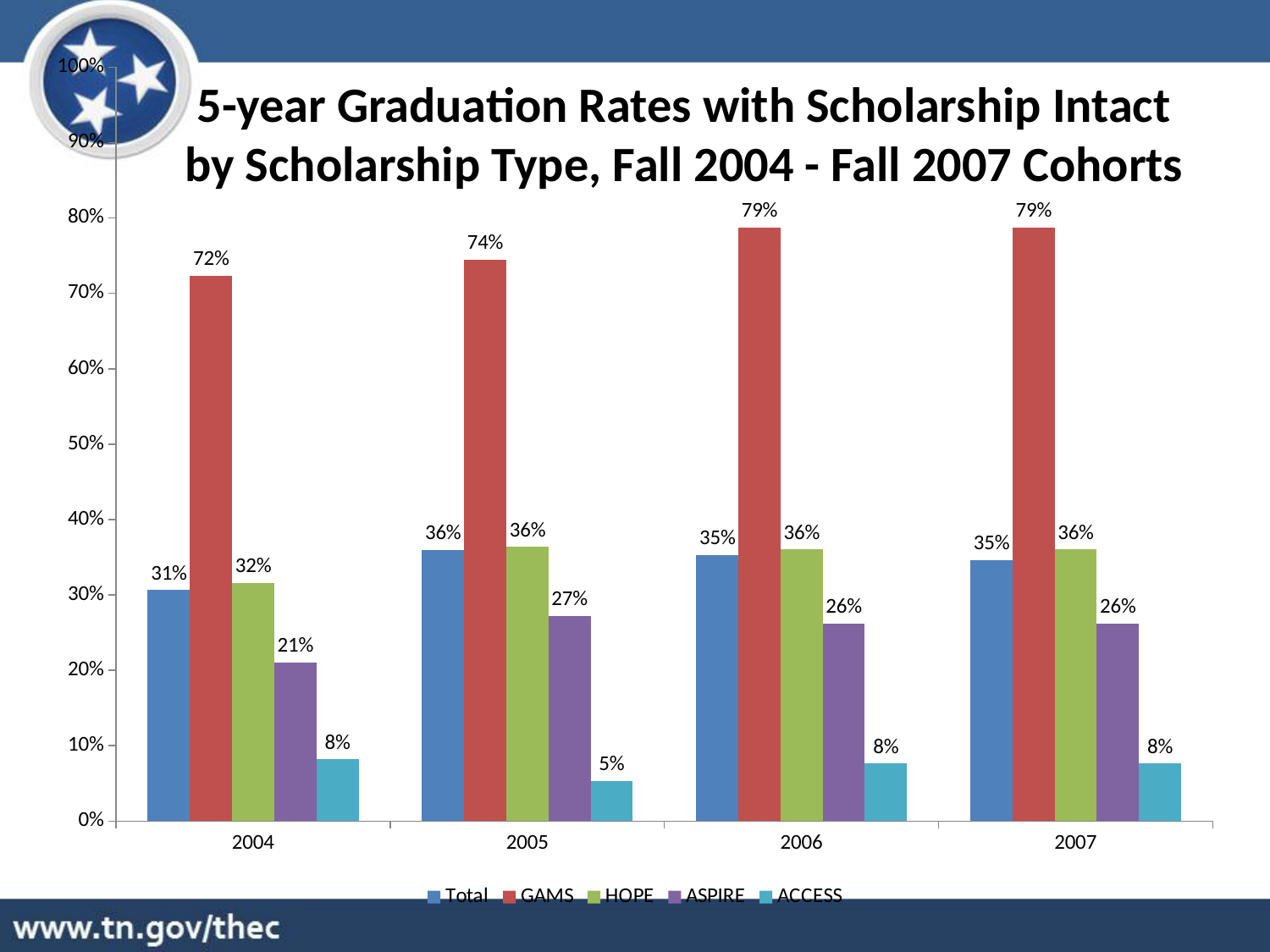
What is the difference between the GAMS and HOPE values in the 2005 cohort? 38% What kind of chart is shown on the slide? Bar chart How many cohort years are shown on the x axis? 4 What is the value for ACCESS in the 2005 cohort? 5% What is the 5-year graduation rate for GAMS in the 2004 cohort? 72% Which scholarship type has the lowest graduation rate in the 2004 cohort? ACCESS Which is larger in the 2004 cohort, the Total value or the HOPE value? HOPE Which scholarship type has the highest graduation rate in the 2006 cohort? GAMS What is the title of the chart? 5-year Graduation Rates with Scholarship Intact by Scholarship Type, Fall 2004 - Fall 2007 Cohorts How many series does the legend list? 5 What is the value for ASPIRE in the 2007 cohort? 26% Does the GAMS graduation rate rise or fall from 2004 to 2006? Rise